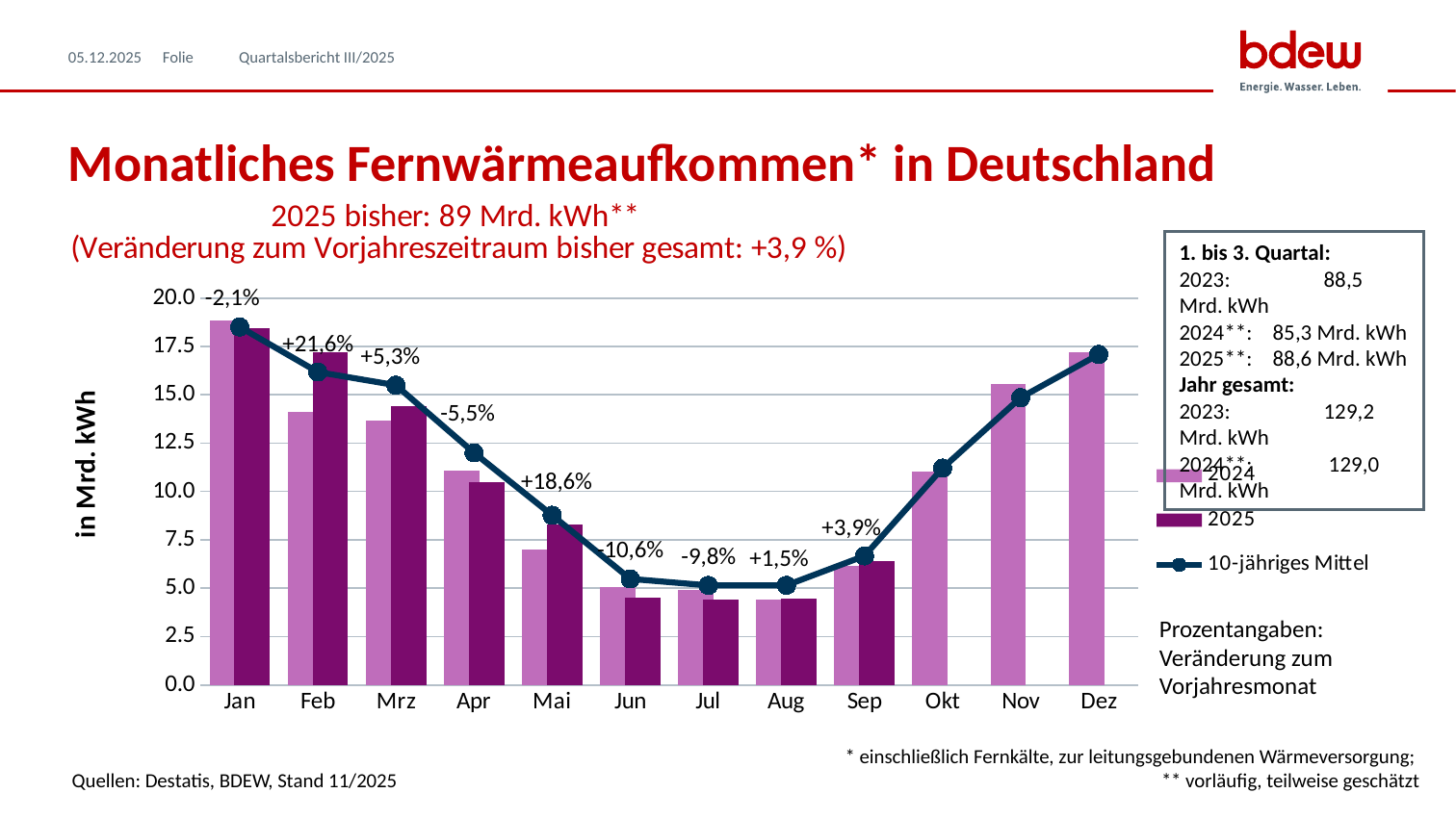
Do the 2024 bars rise or fall from Jan to Aug? fall Is the 2024 bar for Jan greater or less than 17.5? greater How many entries does the chart legend list? 3 For Feb, which bar is taller, 2024 or 2025? 2025 What percentage change is printed above the bars for Feb? +21,6% Which month has the highest printed percentage change? Feb What is the label on the y axis of the chart? in Mrd. kWh Is the 2024 bar for Aug greater or less than 5.0? less Which month has the lowest printed percentage change? Jun What percentage change is printed above the bars for Jun? -10,6% How many months are shown on the x axis of the chart? 12 What kind of chart is shown on the slide? combination bar and line chart